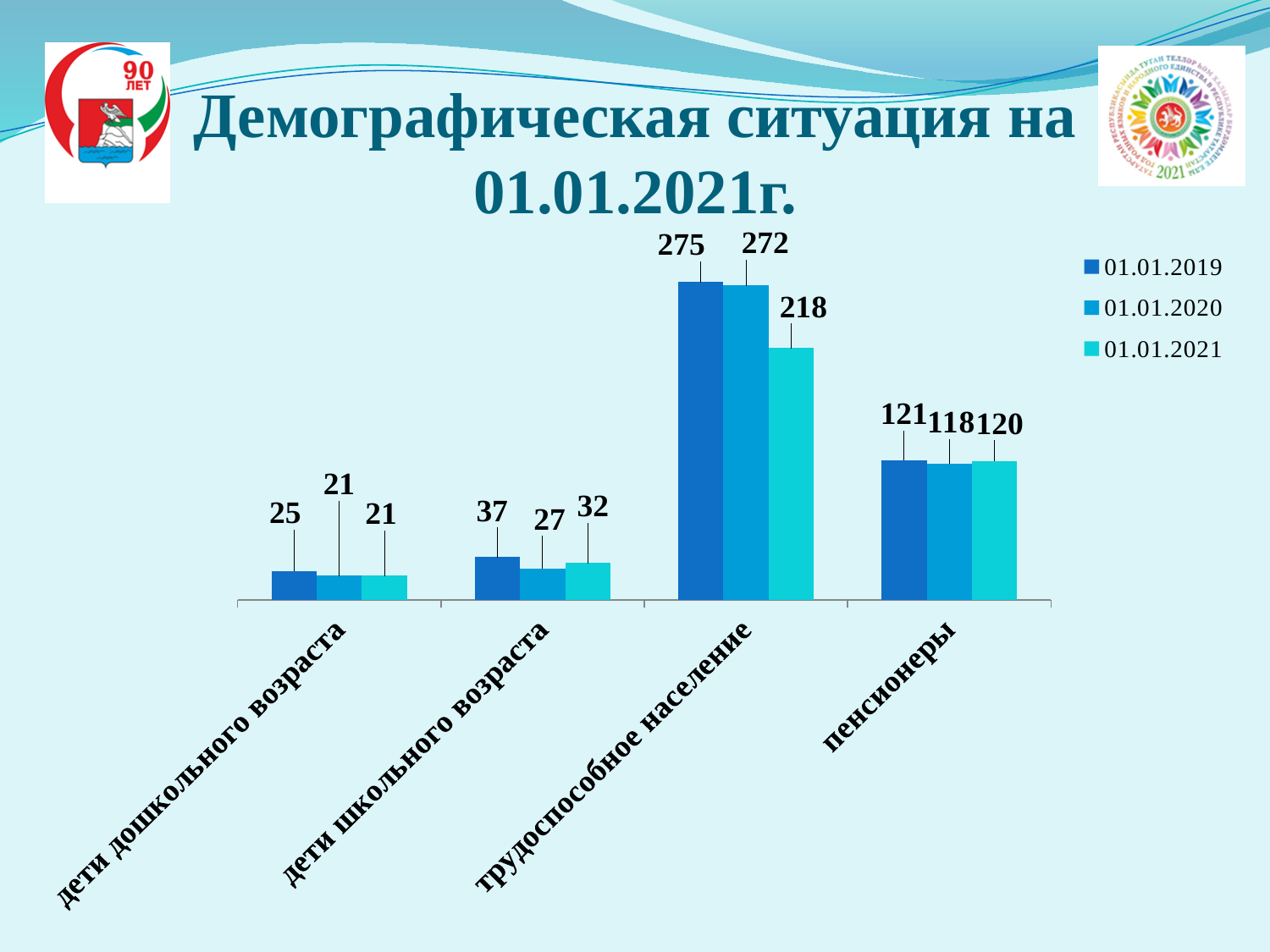
What is the value for пенсионеры on 01.01.2020? 118 What kind of chart is shown on the slide? bar chart What is the value for дети школьного возраста on 01.01.2021? 32 Which category has the highest value on 01.01.2019? трудоспособное население What is the value for дети дошкольного возраста on 01.01.2019? 25 Which is larger for дети школьного возраста: the 01.01.2020 value or the 01.01.2021 value? 01.01.2021 How many categories are shown on the x axis? 4 What is the difference between the 01.01.2019 and 01.01.2021 values for трудоспособное население? 57 Which category has the lowest value on 01.01.2021? дети дошкольного возраста What is the title of the slide? Демографическая ситуация на 01.01.2021г. How many series does the legend list? 3 What is the value for трудоспособное население on 01.01.2021? 218